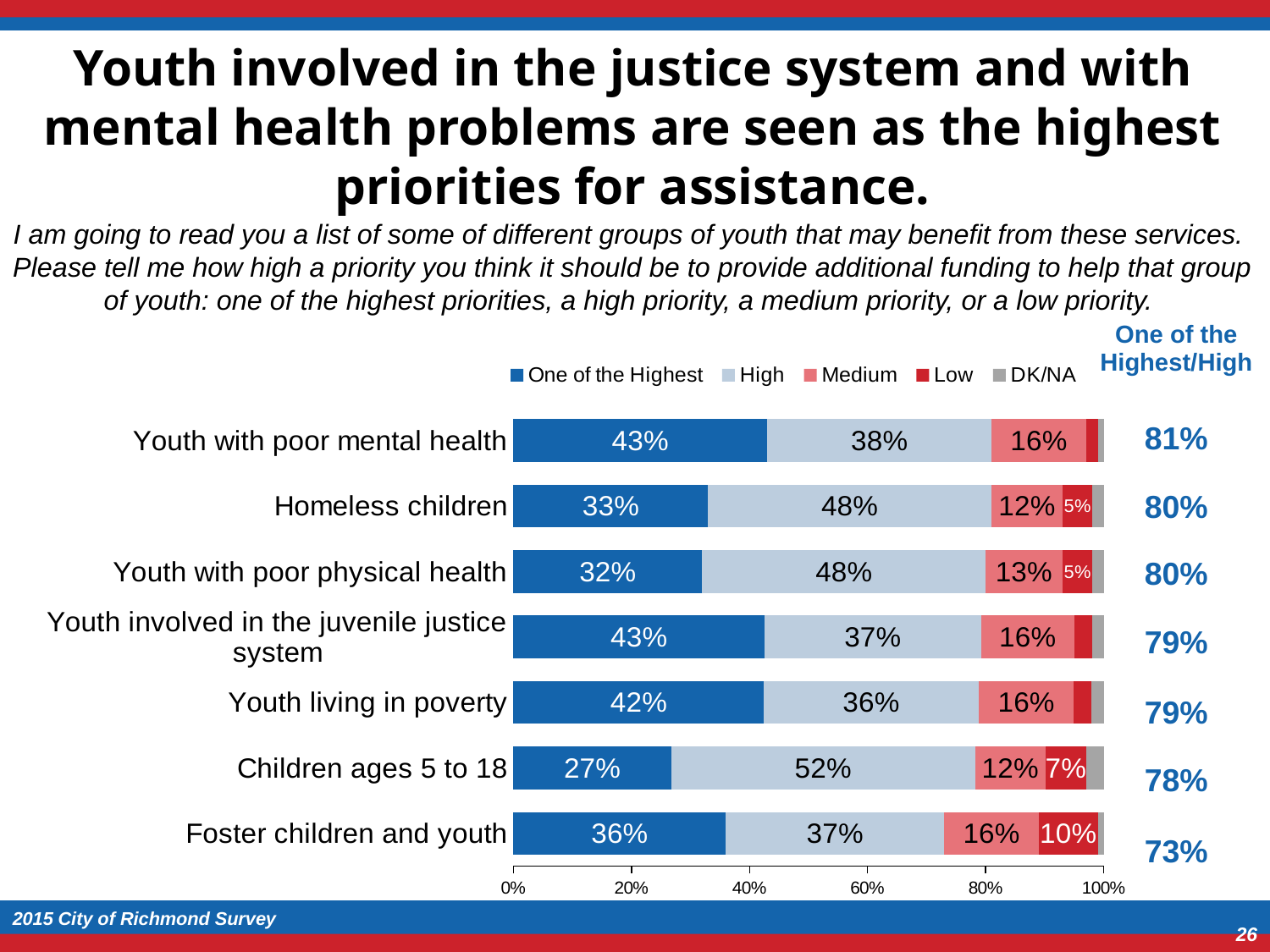
What kind of chart is shown on the slide? Stacked bar chart What is the "High" value for homeless children? 48% What percentage of respondents rated youth with poor mental health as "One of the Highest" priority? 43% How many series does the legend list? 5 What is the difference between the "One of the Highest" values for youth with poor mental health and children ages 5 to 18? 16 percentage points Which group has the highest combined "One of the Highest/High" percentage? Youth with poor mental health Which group has the lowest combined "One of the Highest/High" percentage? Foster children and youth Which group has the largest "High" share? Children ages 5 to 18 Which has a larger "One of the Highest" share: youth living in poverty or foster children and youth? Youth living in poverty What is the combined "One of the Highest/High" value for children ages 5 to 18? 78% How many groups of youth are shown in the chart? 7 What is the "Low" value for foster children and youth? 10%